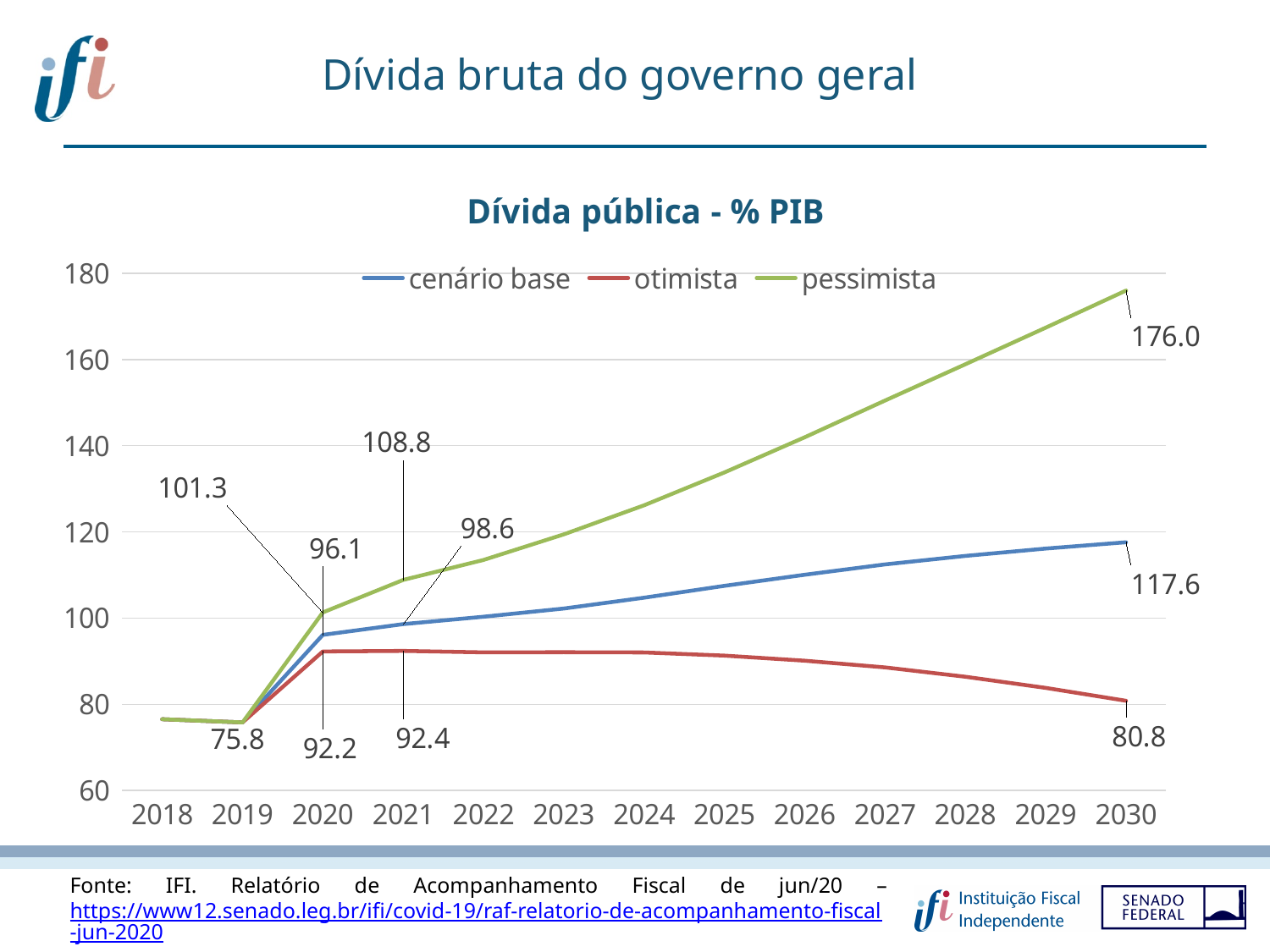
What kind of chart is shown on the slide? line chart How many years are shown on the x axis? 13 What is the value of the pessimista series in 2021? 108.8 How many series does the legend list? 3 What is the value of the otimista series in 2030? 80.8 Does the otimista series rise or fall between 2021 and 2030? fall What is the value of the cenário base series in 2030? 117.6 What is the value of the cenário base series in 2020? 96.1 Which series has the highest value in 2030? pessimista What is the value of the pessimista series in 2030? 176.0 What is the difference between the pessimista and otimista values in 2030? 95.2 Is the value of the pessimista series in 2025 greater or less than 120? greater